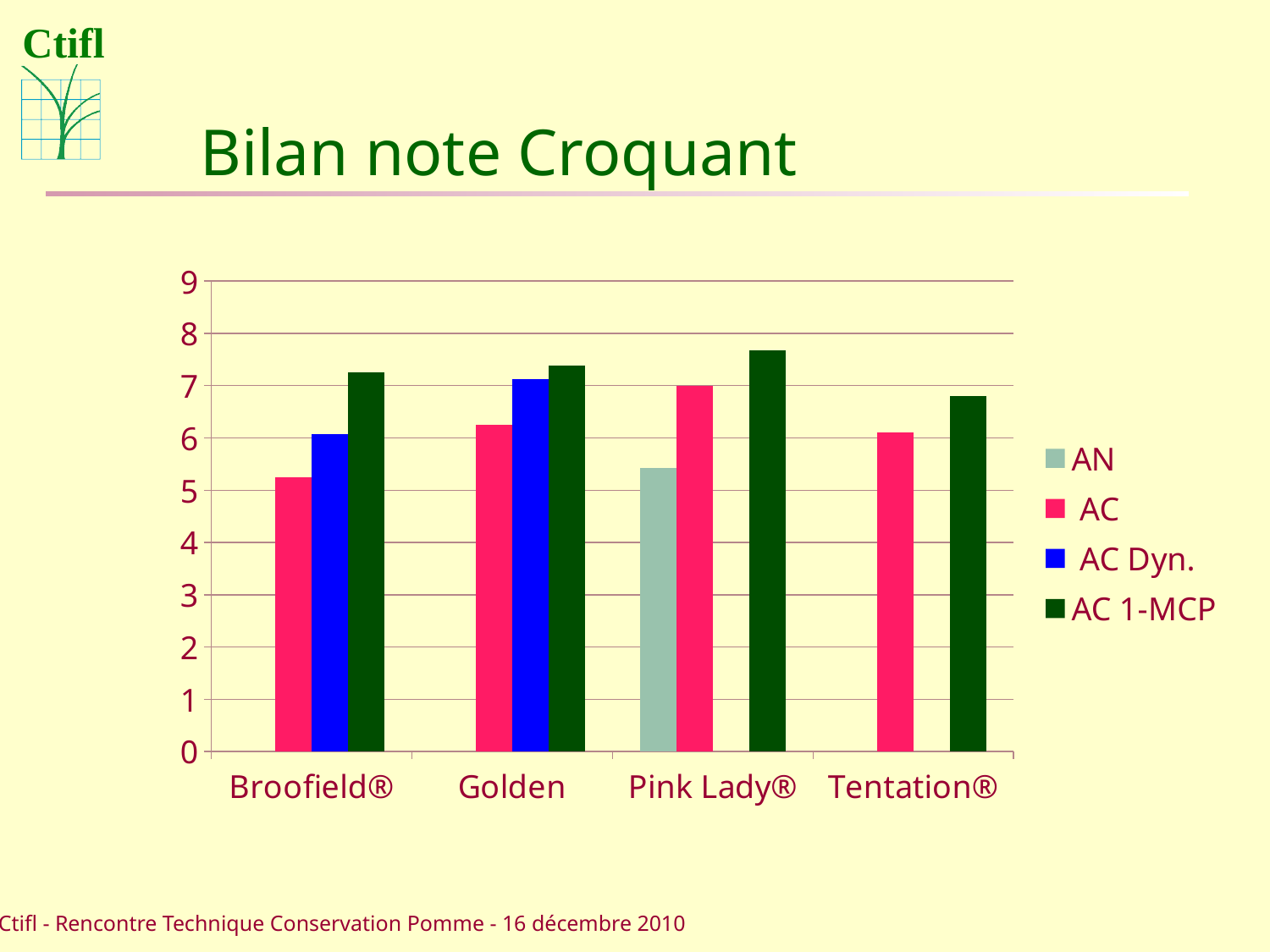
What is the title of the chart? Bilan note Croquant Which variety has the highest AC 1-MCP value? Pink Lady® Which is larger, the AC Dyn. value for Golden or for Broofield®? Golden Is the AC 1-MCP value for Pink Lady® greater or less than 7? greater How many series does the legend list? 4 For Pink Lady®, which is larger, the AC value or the AN value? AC Which variety is the only one with an AN bar? Pink Lady® Which variety has the lowest AC value? Broofield® Is the AC value for Broofield® greater or less than 6? less Is the AC 1-MCP value for Tentation® greater or less than 6? greater How many apple varieties are shown on the x axis? 4 What kind of chart is shown on the slide? bar chart